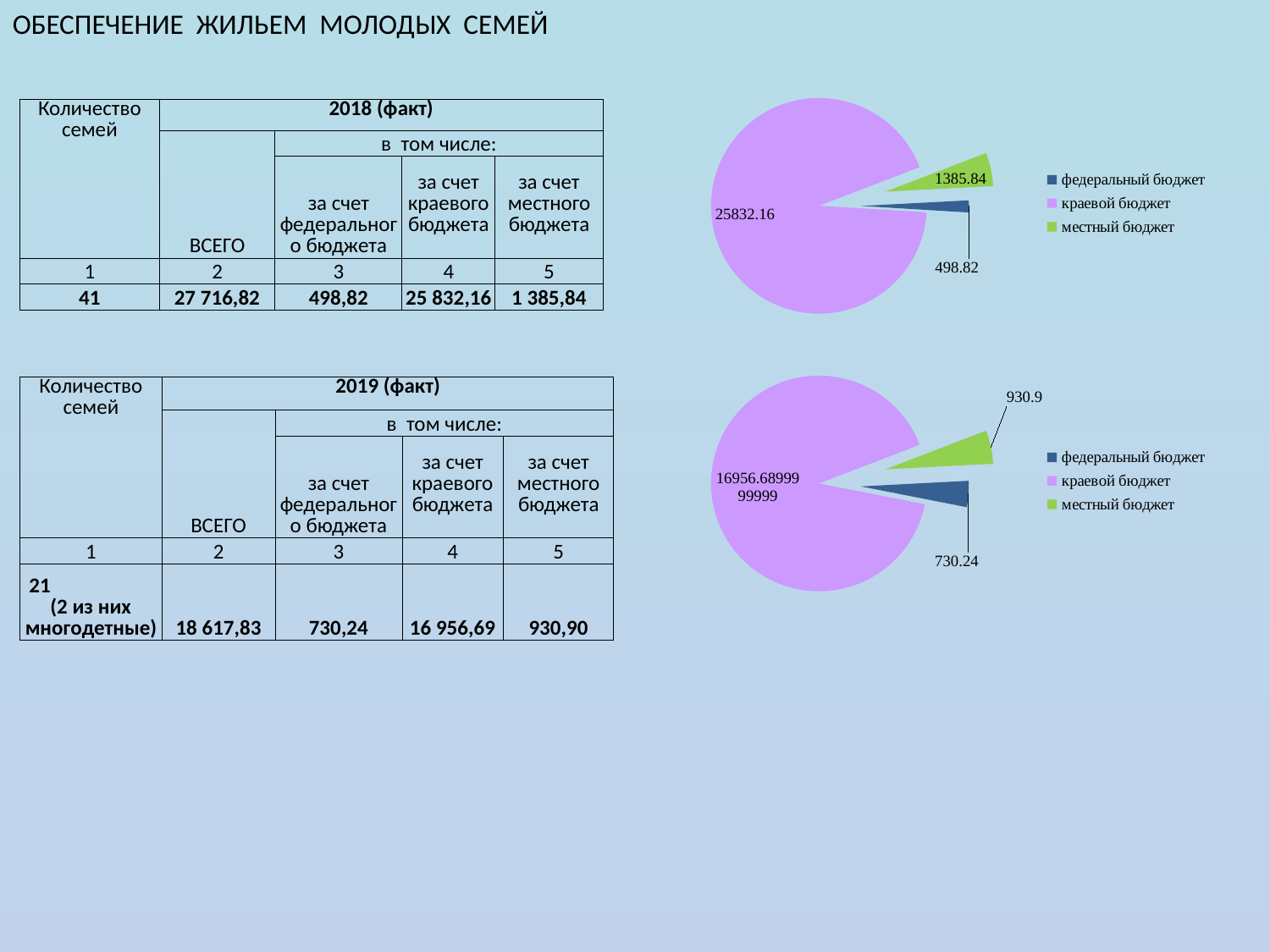
In the bottom pie chart, which is larger, местный бюджет or федеральный бюджет? местный бюджет In the top pie chart, what is the difference between the values for местный бюджет and федеральный бюджет? 887.02 How many slices does the bottom pie chart have? 3 In the top pie chart, what is the value for федеральный бюджет? 498.82 In the bottom pie chart, what is the value for местный бюджет? 930.9 In the top pie chart, which budget has the largest slice? краевой бюджет What kind of chart is the top chart on the right side of the slide? pie chart In the bottom pie chart, what is the value for федеральный бюджет? 730.24 In the top pie chart, which budget has the smallest slice? федеральный бюджет In the top pie chart, what is the value for местный бюджет? 1385.84 In the top pie chart, what is the value for краевой бюджет? 25832.16 In the top pie chart, which colour represents краевой бюджет? purple